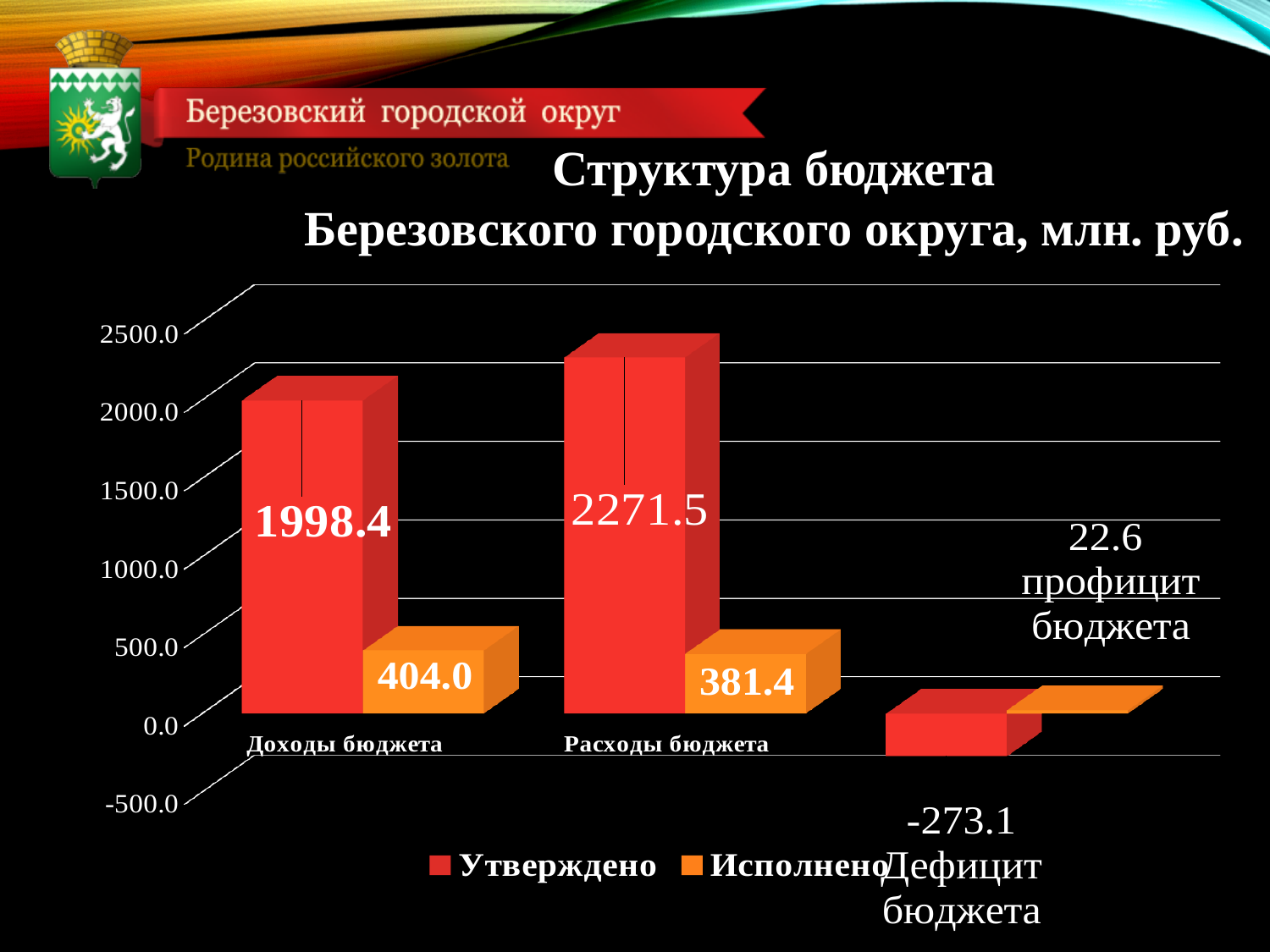
What colour represents the Исполнено series? Orange What is the executed (Исполнено) value for Доходы бюджета? 404.0 What is the executed (Исполнено) value for Расходы бюджета? 381.4 What is the approved (Утверждено) value for Расходы бюджета? 2271.5 What is the approved budget deficit value shown on the chart? -273.1 Which is larger: the executed value for Доходы бюджета or for Расходы бюджета? Доходы бюджета Which category has the highest approved (Утверждено) value? Расходы бюджета What is the approved (Утверждено) value for Доходы бюджета? 1998.4 What type of chart is shown on the slide? Bar chart How many series does the legend list? 2 What is the difference between the approved values for Расходы бюджета and Доходы бюджета? 273.1 What is the executed budget surplus (профицит бюджета) value shown on the chart? 22.6